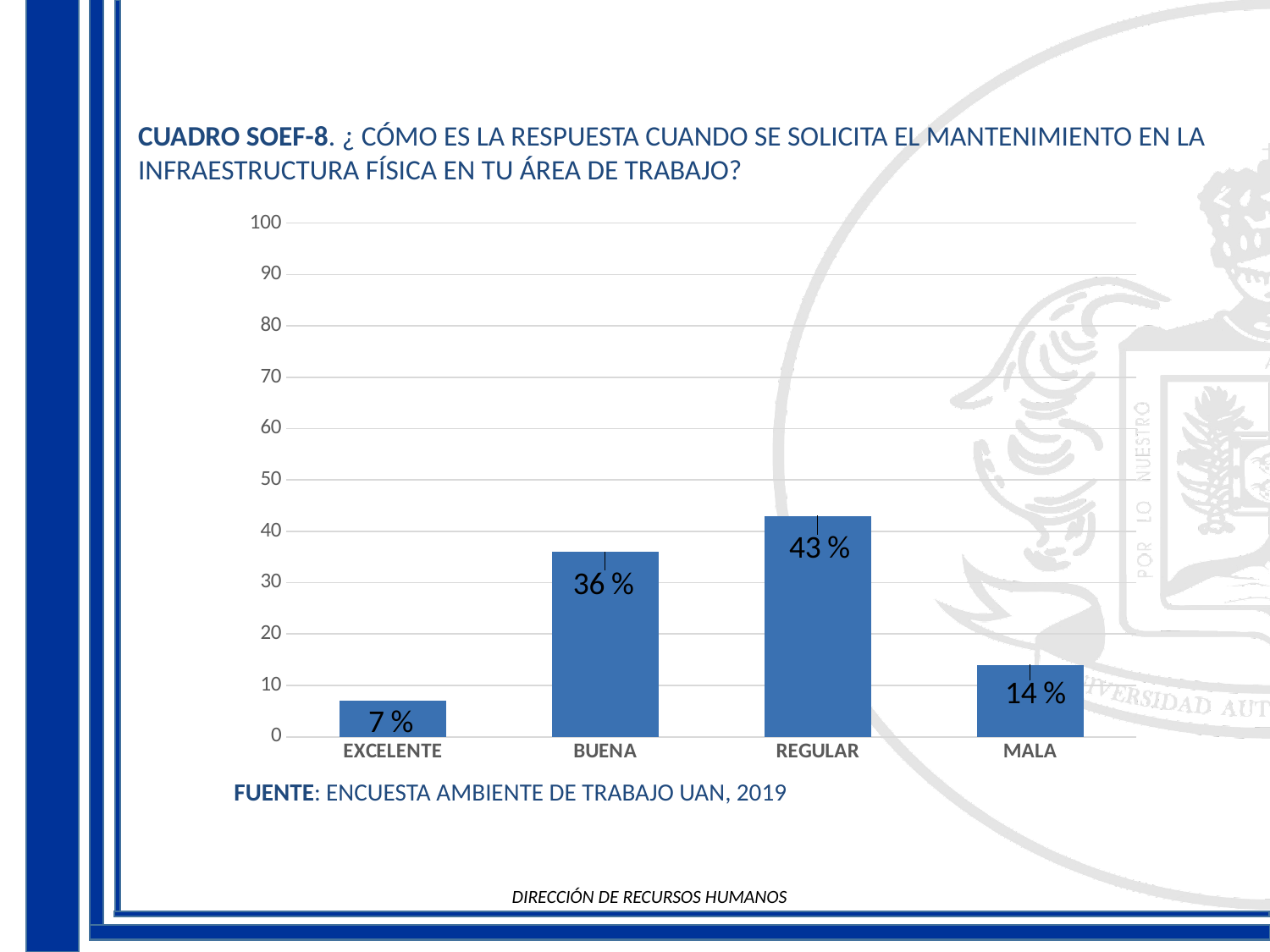
What is the difference between the values for REGULAR and BUENA? 7 % Which is larger, the value for MALA or the value for EXCELENTE? MALA What kind of chart is shown on the slide? bar chart Which category has the highest value? REGULAR Which category has the lowest value? EXCELENTE What source is cited below the chart? ENCUESTA AMBIENTE DE TRABAJO UAN, 2019 What is the value for REGULAR? 43 % How many categories are shown on the x axis? 4 What is the value for EXCELENTE? 7 % What is the value for MALA? 14 % Is the value for BUENA greater or less than 30? greater What is the value for BUENA? 36 %